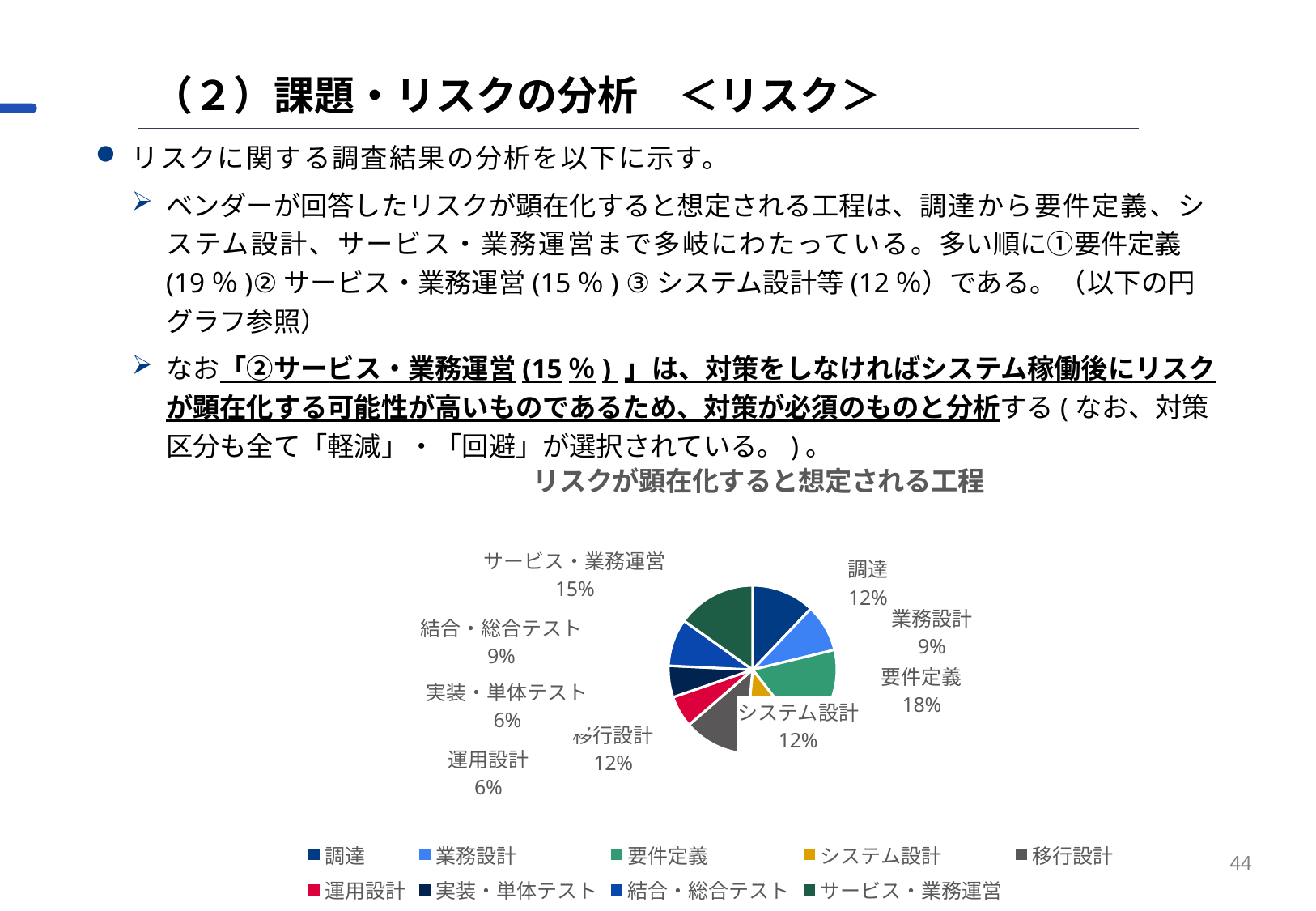
Which is larger, the share for 調達 or the share for 業務設計? 調達 How many categories does the legend list? 9 What is the title of the chart? リスクが顕在化すると想定される工程 Which category has the largest share of the pie? 要件定義 What is the value shown for 調達? 12% What kind of chart is shown on the slide? pie chart What is the value shown for 業務設計? 9% What is the value shown for 結合・総合テスト? 9% What is the difference between the share for 要件定義 and the share for サービス・業務運営? 3 percentage points What share of the pie does サービス・業務運営 account for? 15% What share of the pie does 要件定義 account for? 18% What is the value shown for 運用設計? 6%